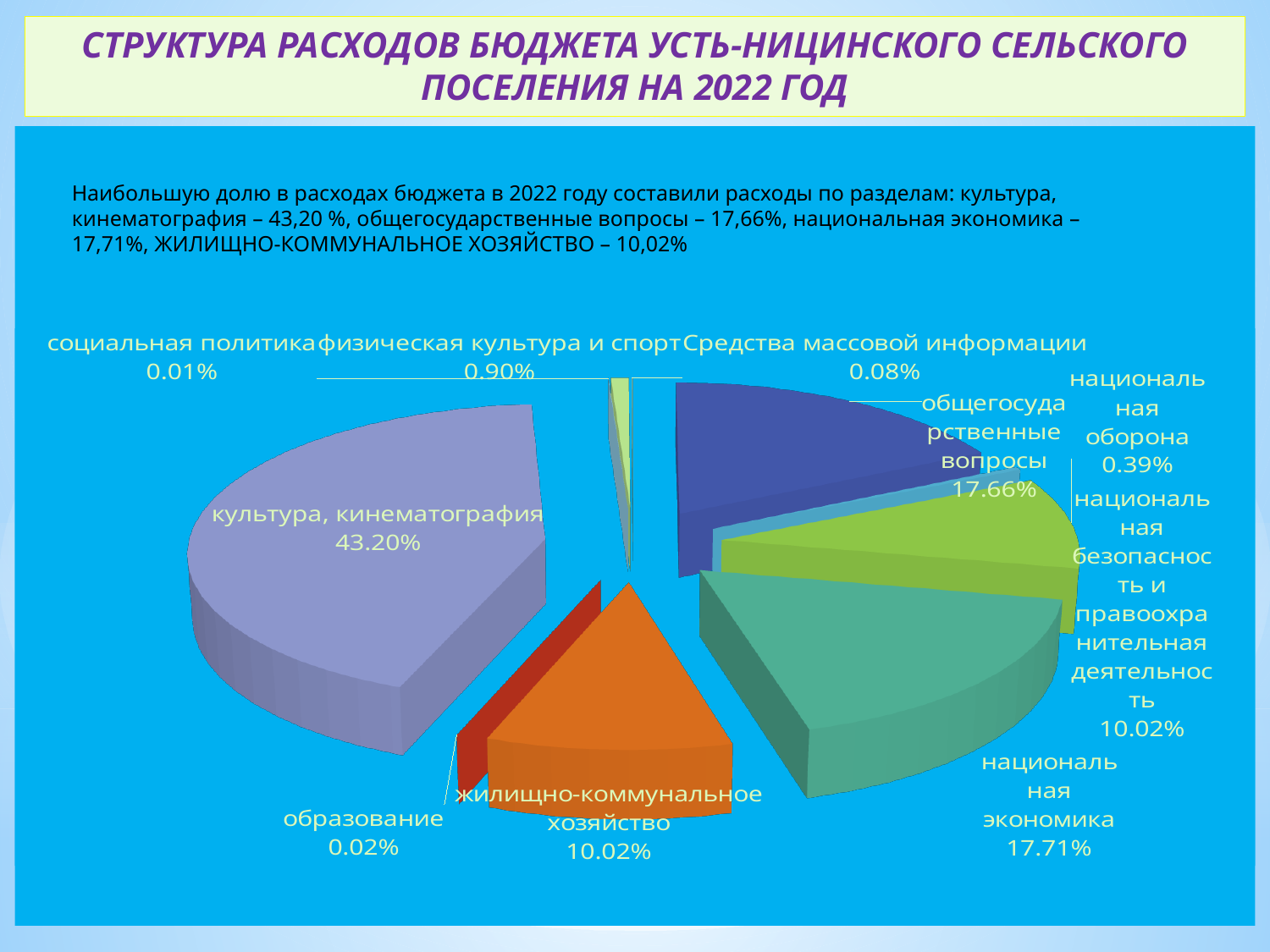
What is the value shown for жилищно-коммунальное хозяйство? 10.02% Which is larger, the share for национальная экономика or for общегосударственные вопросы? национальная экономика What is the value shown for национальная экономика? 17.71% Which category has the largest share of the pie? культура, кинематография What is the difference between the shares of культура, кинематография and национальная экономика? 25.49% What is the value shown for общегосударственные вопросы? 17.66% How many categories are shown in the pie chart? 10 What is the value shown for национальная оборона? 0.39% What share of the budget expenditure does культура, кинематография account for? 43.20% What kind of chart is shown on the slide? pie chart What is the value shown for физическая культура и спорт? 0.90% Which category has the smallest share of the pie? социальная политика